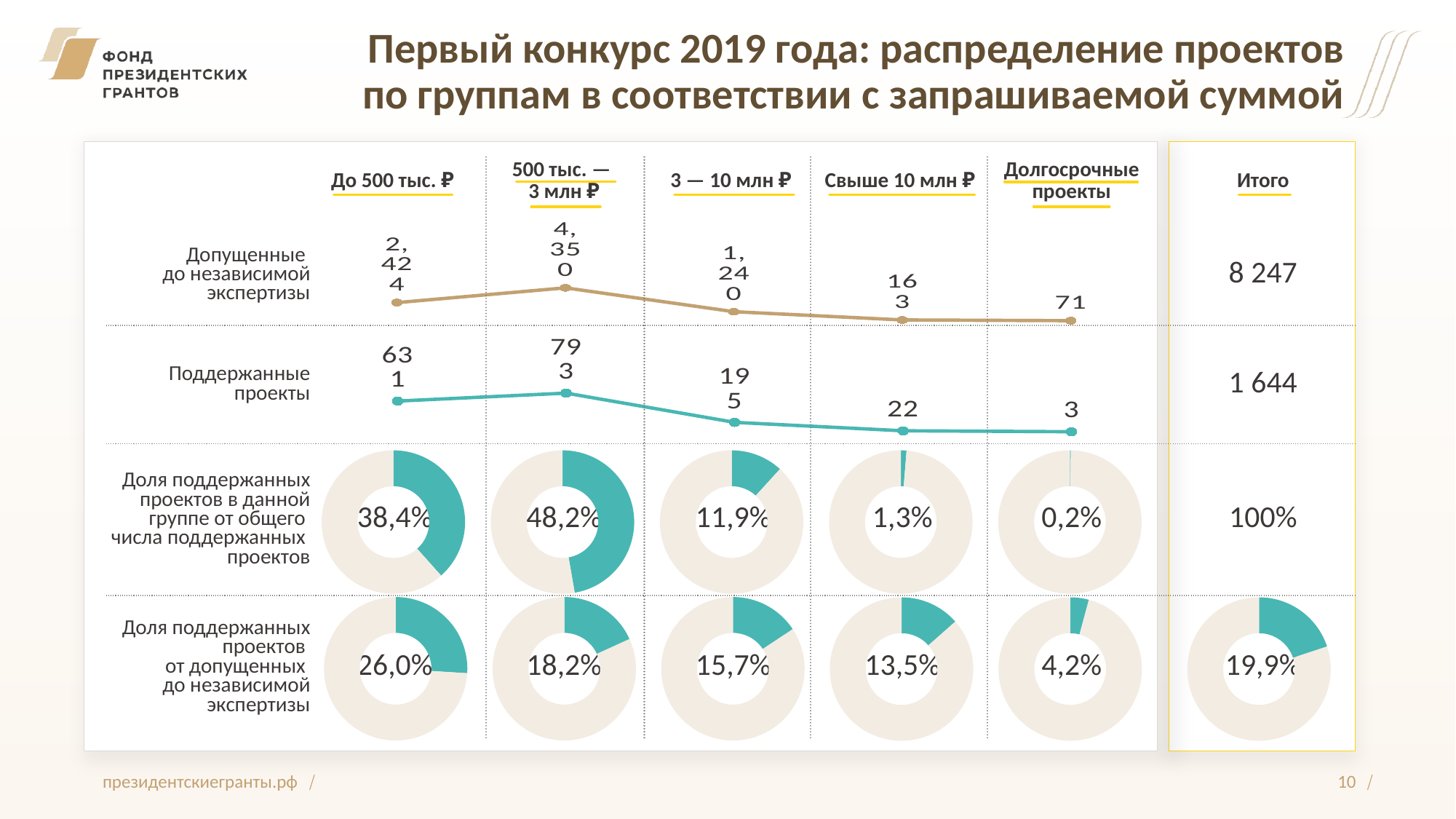
In the row "Доля поддержанных проектов от допущенных до независимой экспертизы", what share is shown for "Долгосрочные проекты"? 4,2% In the row "Поддержанные проекты", what is the value for "Свыше 10 млн ₽"? 22 What kind of chart shows the values in the row "Допущенные до независимой экспертизы"? line chart In the row "Допущенные до независимой экспертизы", what is the value for "Свыше 10 млн ₽"? 163 In the row "Доля поддержанных проектов от допущенных до независимой экспертизы", which is larger: the share for "До 500 тыс. ₽" or for "500 тыс. — 3 млн ₽"? До 500 тыс. ₽ In the row "Поддержанные проекты", what is the value for "Долгосрочные проекты"? 3 In the row "Допущенные до независимой экспертизы", which group has the lowest value? Долгосрочные проекты How many requested-sum groups are plotted along the x axis of the line charts (excluding "Итого")? 5 In the row "Доля поддержанных проектов в данной группе от общего числа поддержанных проектов", what share is shown for "3 — 10 млн ₽"? 11,9% What is the "Итого" value for the row "Поддержанные проекты"? 1 644 In the row "Поддержанные проекты", what is the difference between the values for "До 500 тыс. ₽" and "3 — 10 млн ₽"? 436 In the row "Поддержанные проекты", which group has the highest value? 500 тыс. — 3 млн ₽